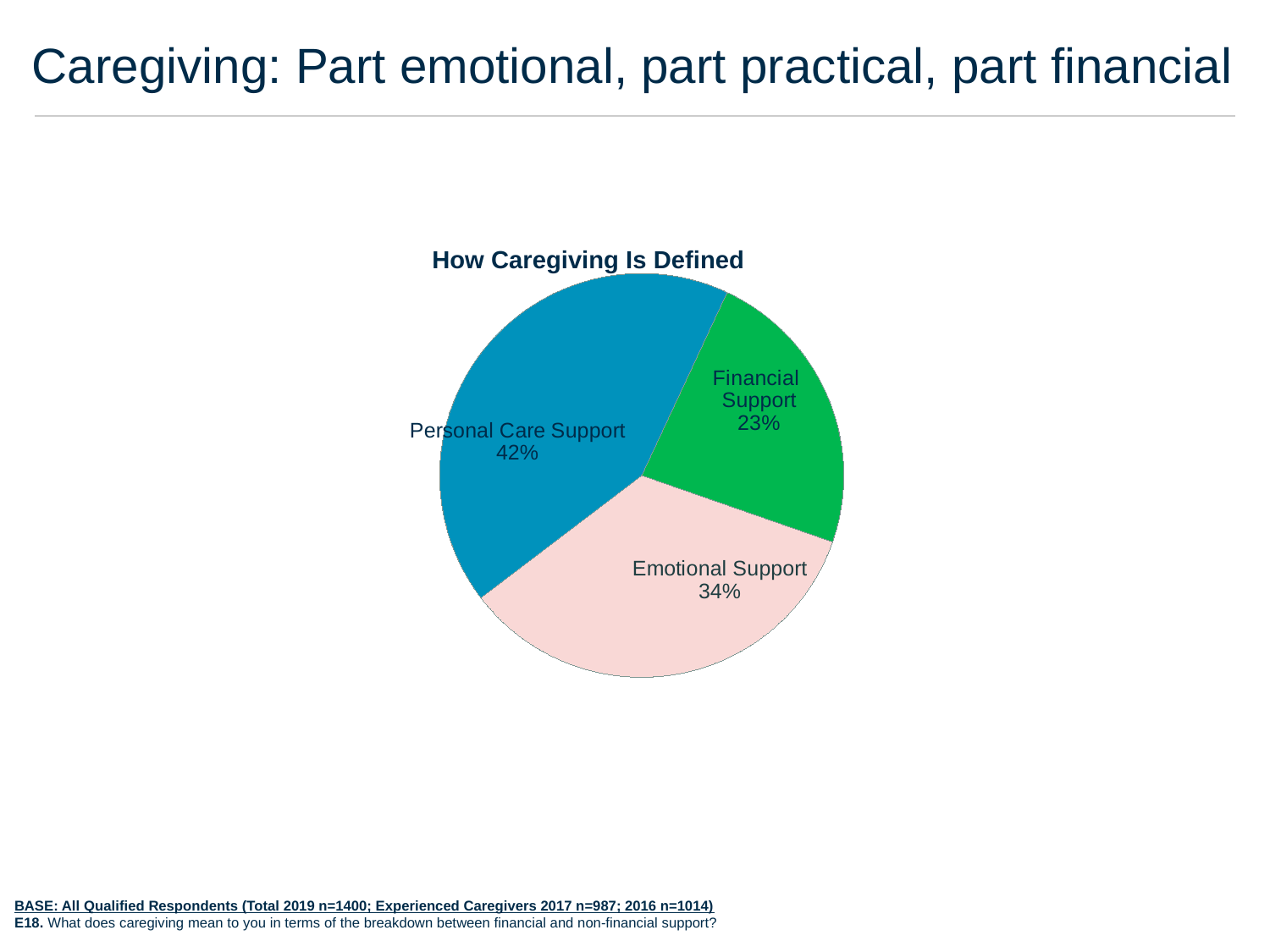
What share of the pie is Personal Care Support? 42% What share of the pie is Financial Support? 23% What colour is the Financial Support slice? Green What is the title of the chart? How Caregiving Is Defined What kind of chart is shown on the slide? Pie chart How many slices does the pie chart have? 3 Which slice of the pie is the smallest? Financial Support Which is larger, Emotional Support or Financial Support? Emotional Support Which slice of the pie is the largest? Personal Care Support What share of the pie is Emotional Support? 34% What is the difference in percentage points between Personal Care Support and Financial Support? 19 What is the difference in percentage points between Personal Care Support and Emotional Support? 8